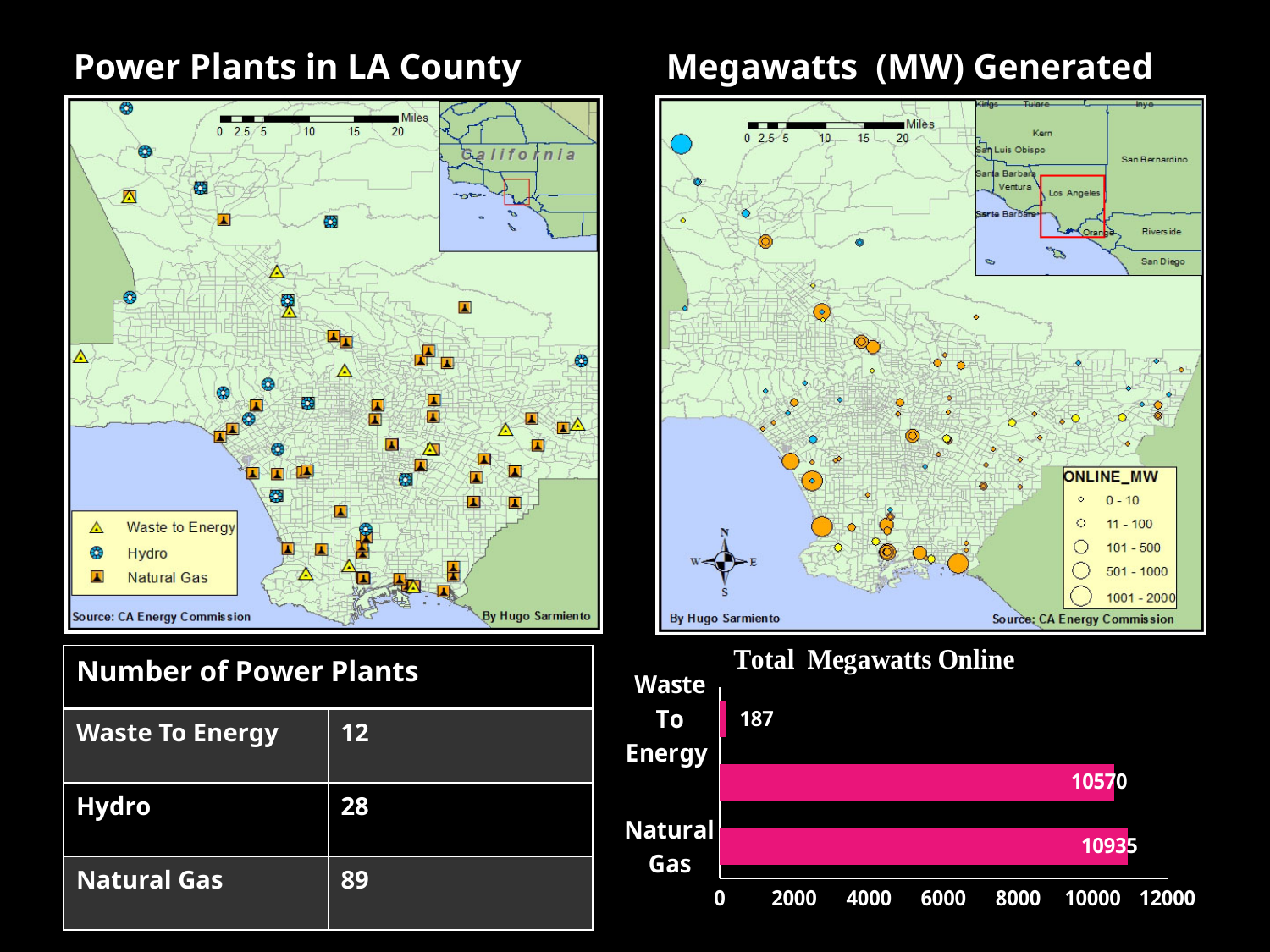
What is the largest tick value shown on the x axis of the Total Megawatts Online chart? 12000 What kind of chart is the Total Megawatts Online chart? bar chart What is the title of the bar chart at the bottom right of the slide? Total Megawatts Online How many bars are plotted in the Total Megawatts Online chart? 3 In the Total Megawatts Online chart, which category has the lowest value? Waste To Energy In the Total Megawatts Online chart, is the value for Natural Gas greater or less than 10000? greater In the Total Megawatts Online chart, which is larger: Natural Gas or Waste To Energy? Natural Gas In the Total Megawatts Online chart, what is the value for Natural Gas? 10935 In the Total Megawatts Online chart, is the value for Waste To Energy greater or less than 2000? less In the Total Megawatts Online chart, what is the difference between the Natural Gas value and the Waste To Energy value? 10748 In the Total Megawatts Online chart, what is the value for Waste To Energy? 187 In the Total Megawatts Online chart, which labelled category has the highest value? Natural Gas